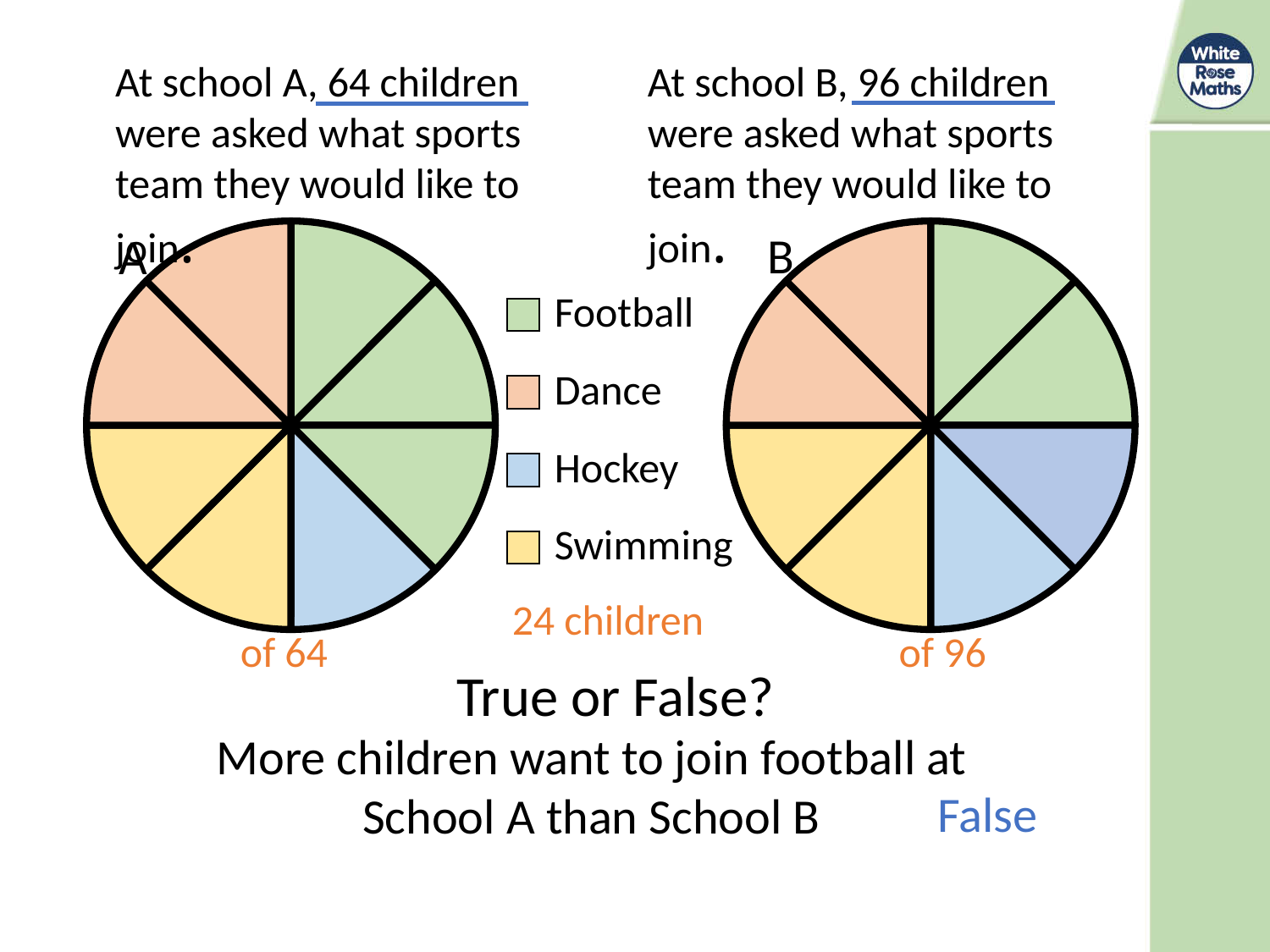
According to the slide, is the statement 'More children want to join football at School A than School B' true or false? False In pie chart A, which sport has the largest share? Football Which colour represents Swimming in the legend? Yellow In pie chart B, what fraction of the pie is Hockey? 1/4 How many categories does the legend list? 4 How many equal sectors is pie chart B divided into? 8 How many children were asked at school B, according to the label under pie chart B? 96 In pie chart A, which is larger, the Football slice or the Hockey slice? Football In pie chart A, how many children want to join football, as labelled on the slide? 24 children What kind of charts are shown on the slide? Pie charts In pie chart A, which sport has the smallest share? Hockey In pie chart A, what fraction of the pie is Football? 3/8